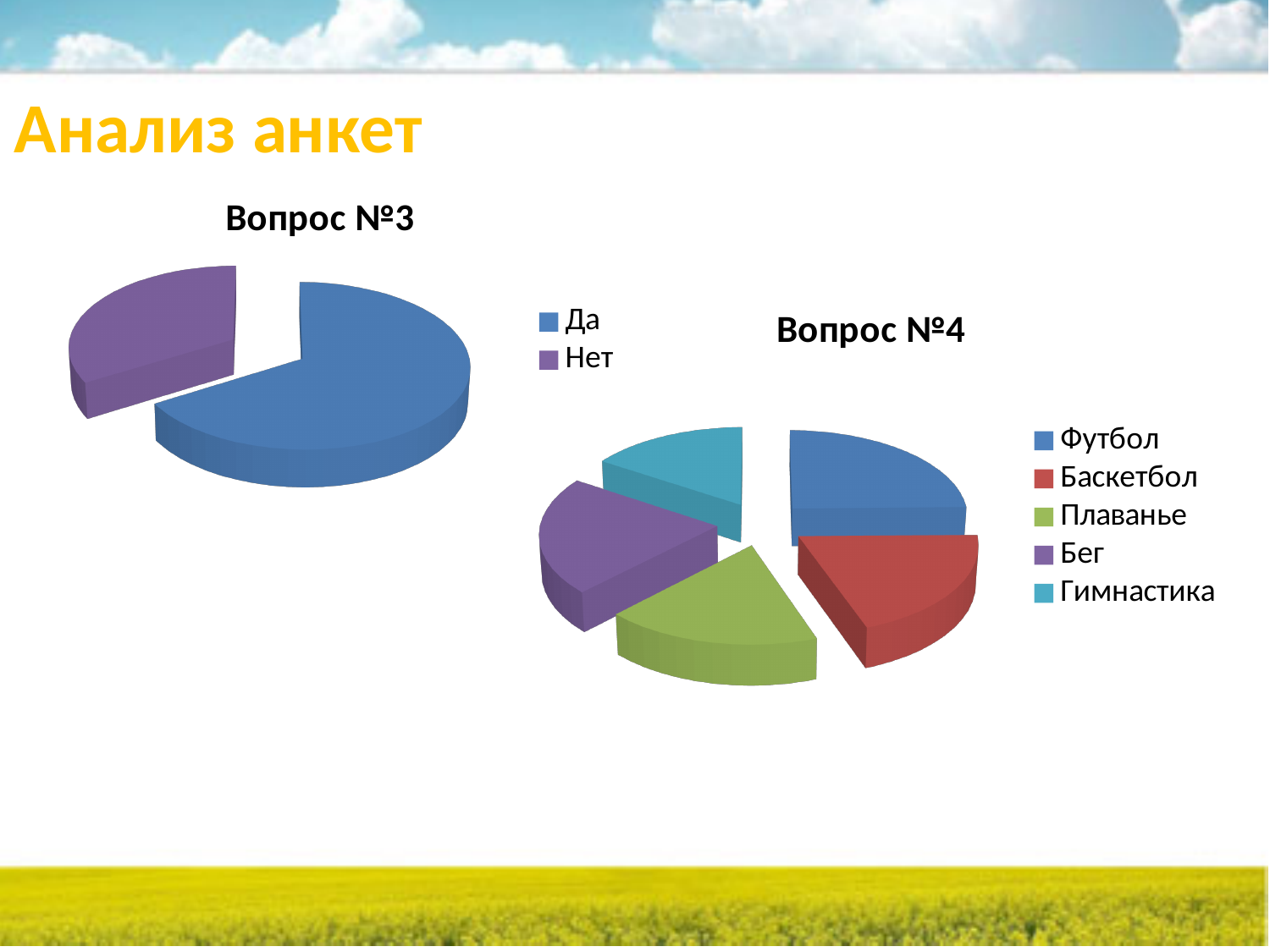
What kind of chart is the chart titled "Вопрос №4"? pie chart What is the title of the pie chart on the left side of the slide? Вопрос №3 In the chart titled "Вопрос №3", which category has the largest slice? Да In the chart titled "Вопрос №3", how many categories are shown? 2 In the chart titled "Вопрос №4", how many categories are shown? 5 In the chart titled "Вопрос №4", which category is shown in red? Баскетбол What kind of chart is the chart titled "Вопрос №3"? pie chart In the chart titled "Вопрос №3", which category has the smallest slice? Нет In the chart titled "Вопрос №4", which slice is larger, Плаванье or Гимнастика? Плаванье How many entries does the legend of the chart titled "Вопрос №4" list? 5 In the chart titled "Вопрос №3", which slice is larger, Да or Нет? Да